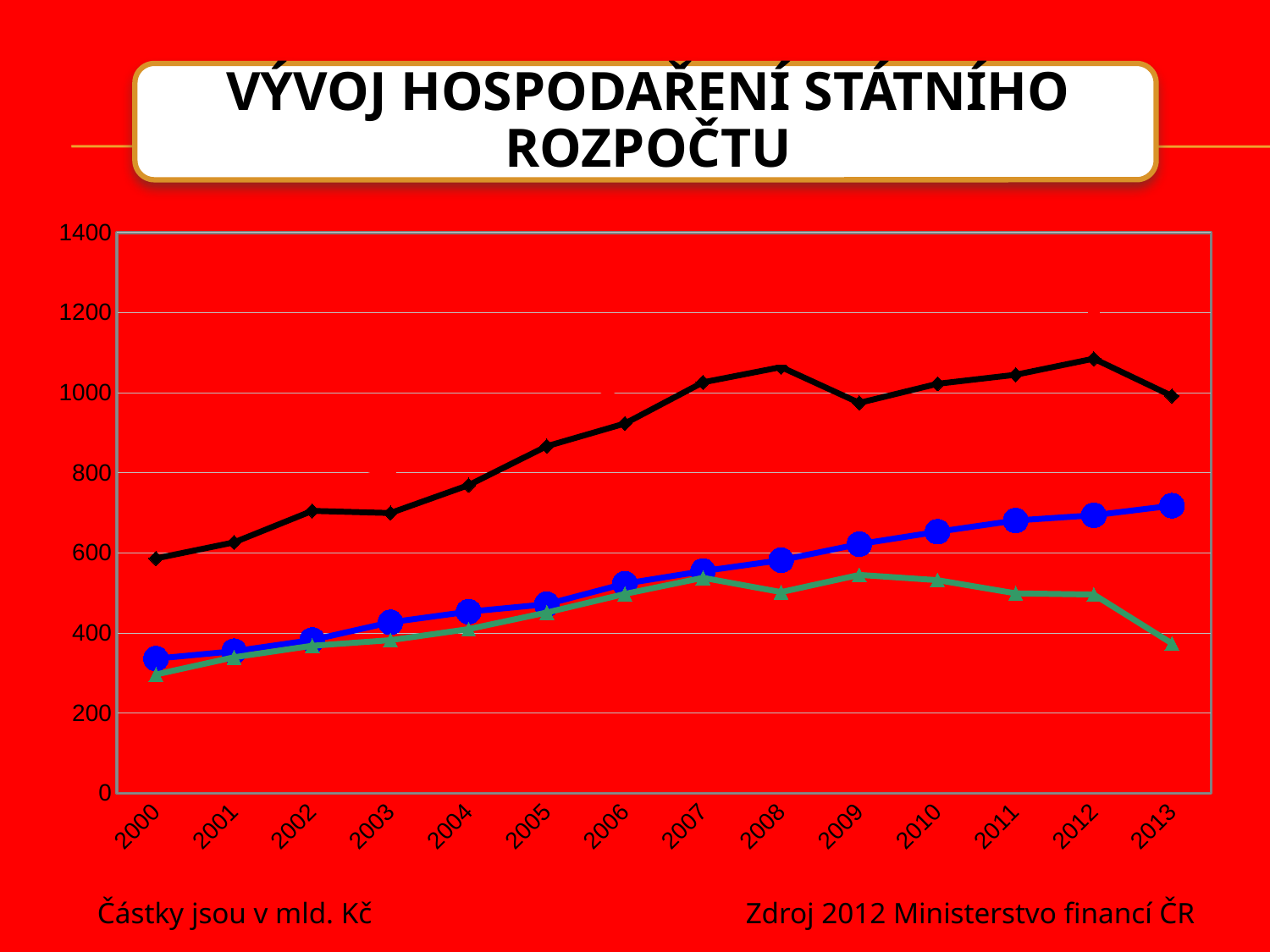
Is the value of the green line in 2013 greater or less than 400? less Is the value of the black line in 2012 greater or less than 1000? greater In 2013, which line has the higher value, the blue line or the green line? the blue line In which year is the green line at its lowest value? 2000 How many years are plotted along the x axis? 14 In which year is the black line at its lowest value? 2000 Does the blue line generally rise or fall from 2000 to 2013? rise In which year does the black line reach its highest value? 2012 What kind of chart is shown on the slide? line chart Is the value of the blue line in 2013 greater or less than 800? less In which year does the blue line reach its highest value? 2013 How many lines are plotted on the chart? 3